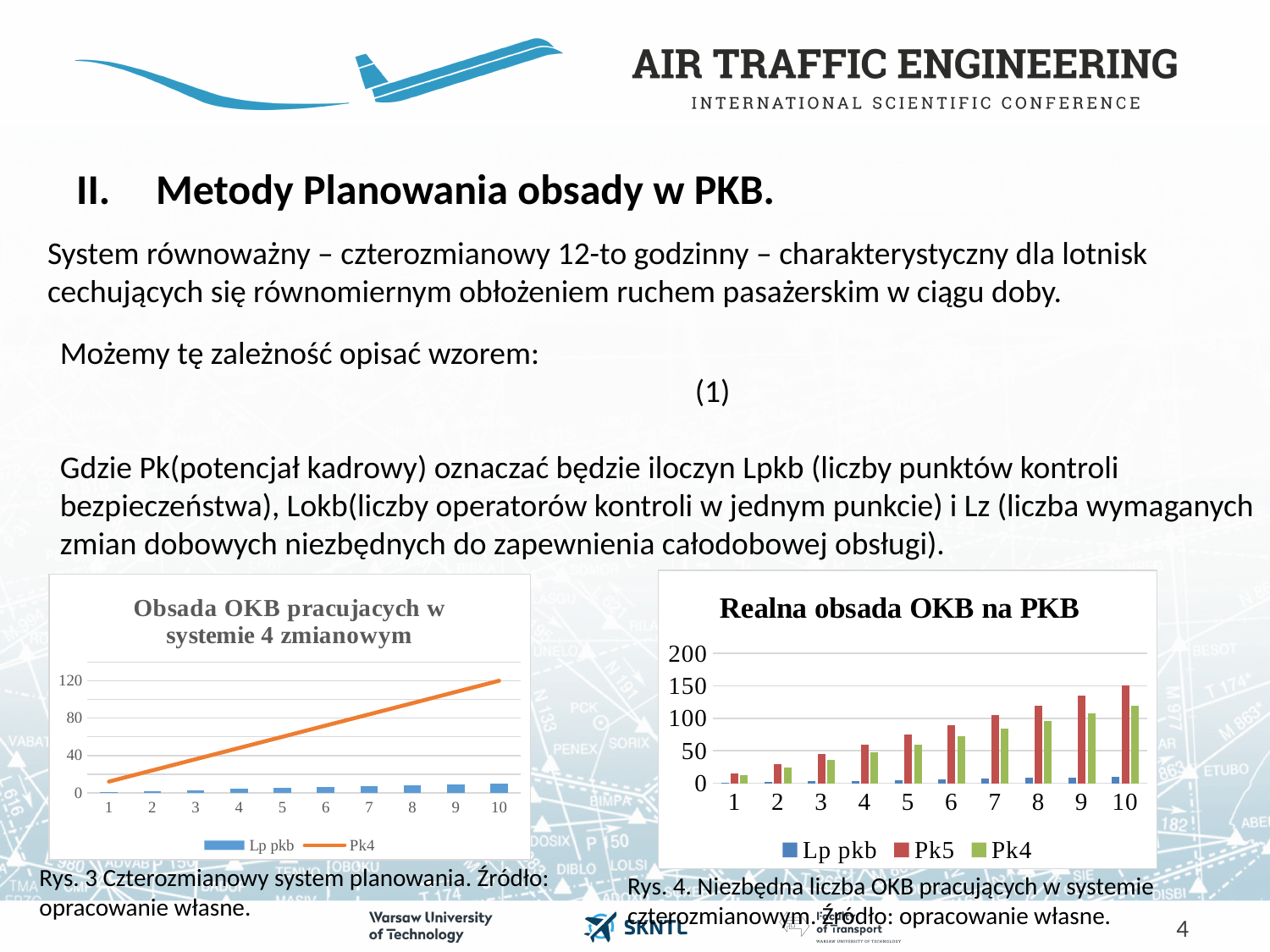
In the chart titled "Obsada OKB pracujacych w systemie 4 zmianowym", is the Pk4 value at category 10 greater or less than 80? greater In the chart titled "Realna obsada OKB na PKB", at which category is the Pk5 series highest? 10 In the chart titled "Realna obsada OKB na PKB", which is larger at category 10: Pk5 or Pk4? Pk5 What kind of chart is the chart titled "Realna obsada OKB na PKB"? bar chart What is the title of the chart on the left side of the slide? Obsada OKB pracujacych w systemie 4 zmianowym How many series does the legend of the chart titled "Obsada OKB pracujacych w systemie 4 zmianowym" list? 2 How many series does the legend of the chart titled "Realna obsada OKB na PKB" list? 3 In the chart titled "Realna obsada OKB na PKB", is the Pk4 value at category 2 greater or less than 50? less In the chart titled "Obsada OKB pracujacych w systemie 4 zmianowym", is the Pk4 value at category 1 greater or less than 40? less In the chart titled "Realna obsada OKB na PKB", do the Pk5 values rise or fall from category 1 to category 10? rise How many categories are shown on the x axis of the chart titled "Realna obsada OKB na PKB"? 10